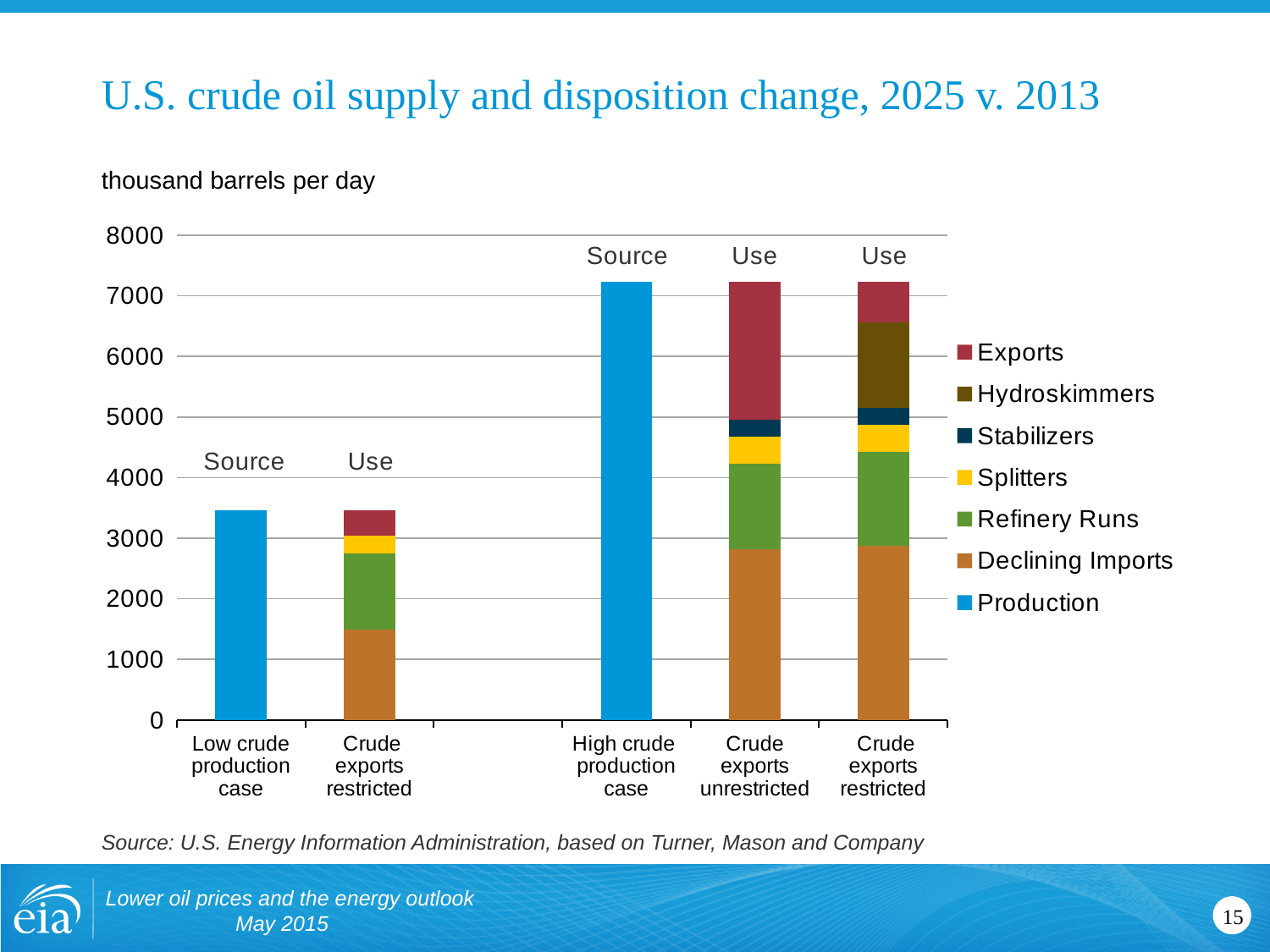
Which bar is taller: High crude production case or Low crude production case? High crude production case In the high crude production case, which bar has the larger Exports segment: Crude exports unrestricted or Crude exports restricted? Crude exports unrestricted Is the Declining Imports segment in the Crude exports unrestricted bar greater or less than 2000? greater How many bars are plotted on the chart? 5 How many series does the legend list? 7 What is the unit of measurement shown above the chart? thousand barrels per day Which bar is the only one that includes a Hydroskimmers segment? Crude exports restricted (high crude production case) Is the value for the Low crude production case bar greater or less than 3000? greater Is the total of the Crude exports unrestricted bar greater or less than 6000? greater What kind of chart is shown on the slide? stacked bar chart